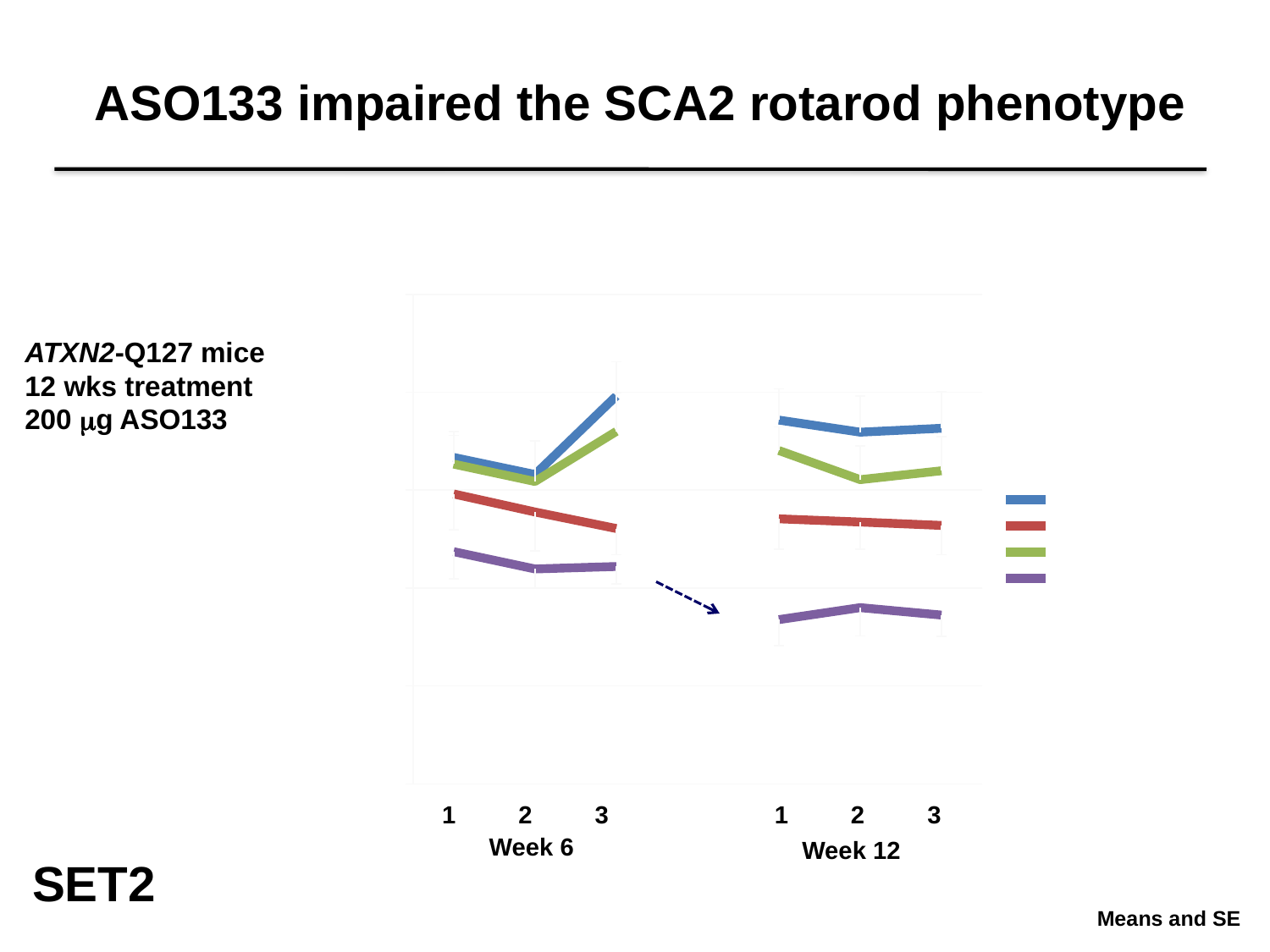
How many series does the legend list? 4 How many trial points are shown under Week 6? 3 Which coloured line is highest at Week 12? blue Does the blue line rise or fall from trial 2 to trial 3 in Week 6? rise At trial 1 of Week 12, is the blue line or the purple line higher? blue What kind of chart is shown on the slide? line chart What is the title of the slide containing the chart? ASO133 impaired the SCA2 rotarod phenotype At trial 3 of Week 6, is the green line or the red line higher? green What are the two group labels on the x axis? Week 6 and Week 12 Does the red line rise or fall from trial 1 to trial 3 in Week 6? fall How many x-axis points are plotted in total across Week 6 and Week 12? 6 Which coloured line is lowest at Week 12? purple